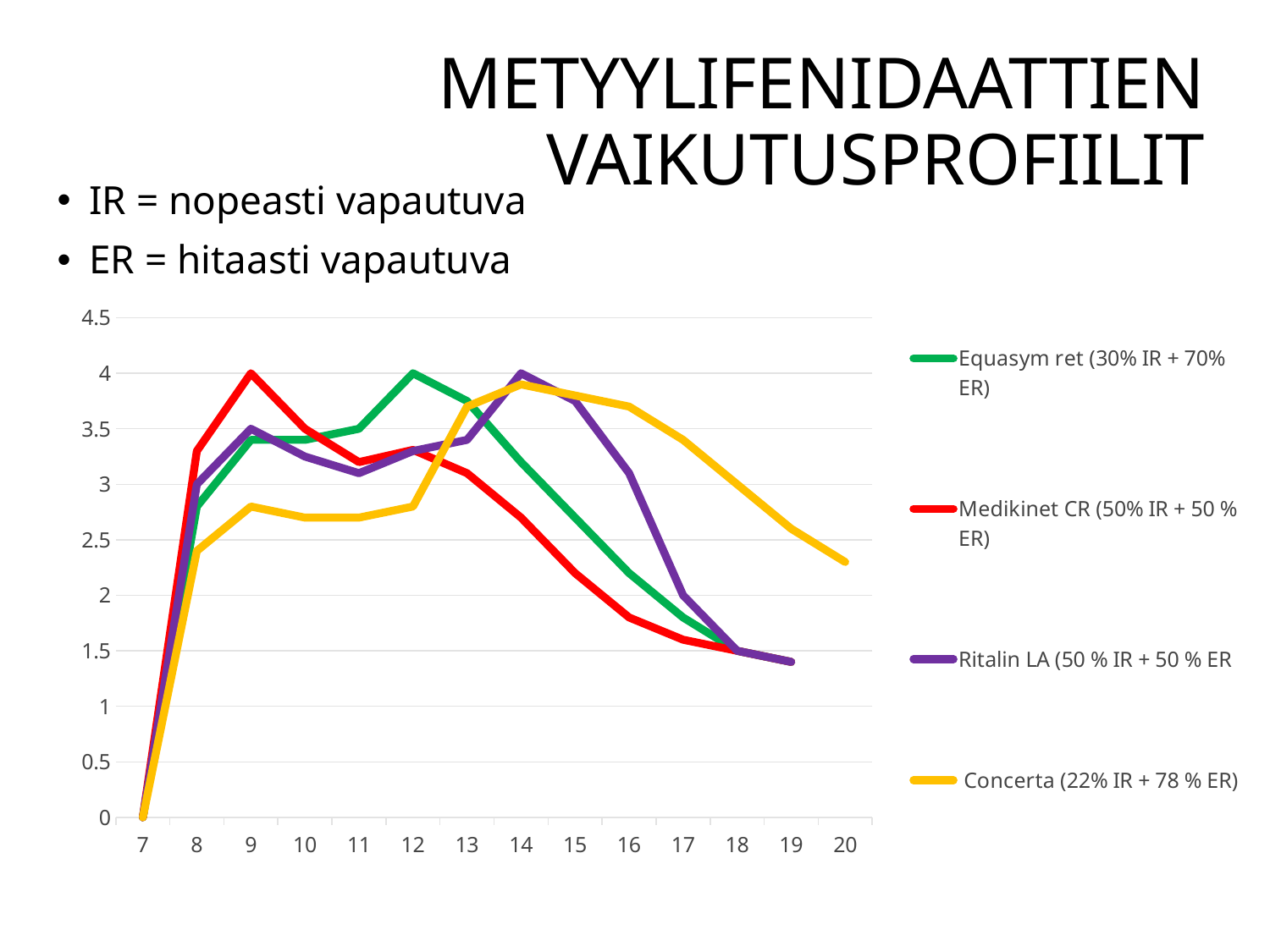
Which series has the lowest value at x = 10? Concerta (22% IR + 78 % ER) Which series is drawn in yellow? Concerta (22% IR + 78 % ER) What is the value of Medikinet CR at x = 9? 4 At x = 18, which is larger: Concerta or Medikinet CR? Concerta Is the value for Concerta at x = 20 greater or less than 2.5? less Which series has the highest value at x = 9? Medikinet CR (50% IR + 50 % ER) What is the value of Ritalin LA at x = 14? 4 Do the Concerta values rise or fall from x = 16 to x = 20? fall What is the value of Equasym ret at x = 12? 4 How many points are labelled on the x axis? 14 What kind of chart is shown on the slide? line chart How many series does the legend list? 4